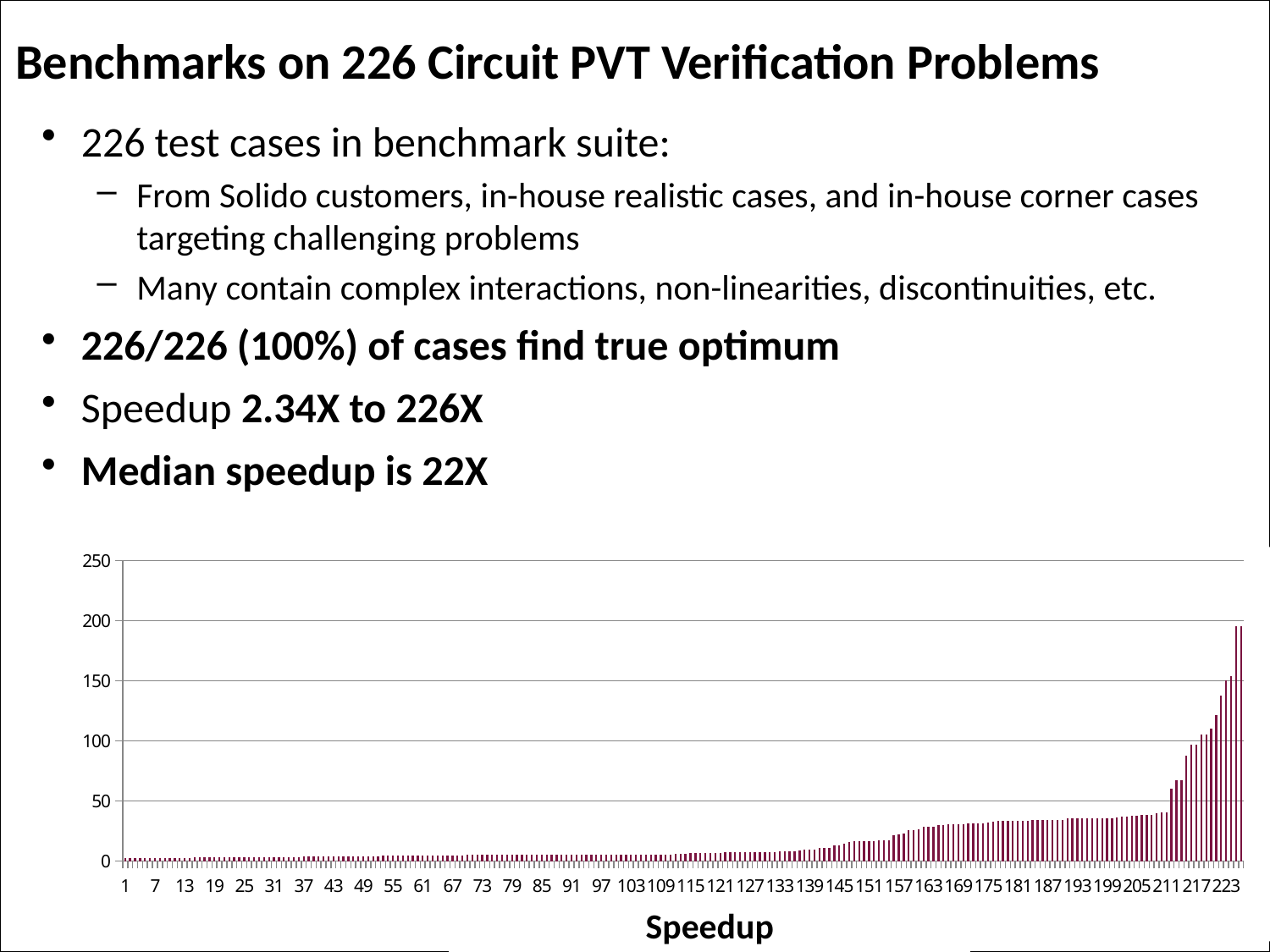
Is the value for category 1 greater or less than 50? less Is the value for category 205 greater or less than 50? less How many test cases does the chart represent, according to the slide? 226 What kind of chart is shown on the slide? bar chart Do the bar values rise or fall from left to right along the x axis? rise Is the value of the rightmost (tallest) bar greater or less than 150? greater What is the title shown beneath the chart? Speedup What is the highest value shown on the y axis? 250 Which is larger, the value for category 1 or the value for category 223? category 223